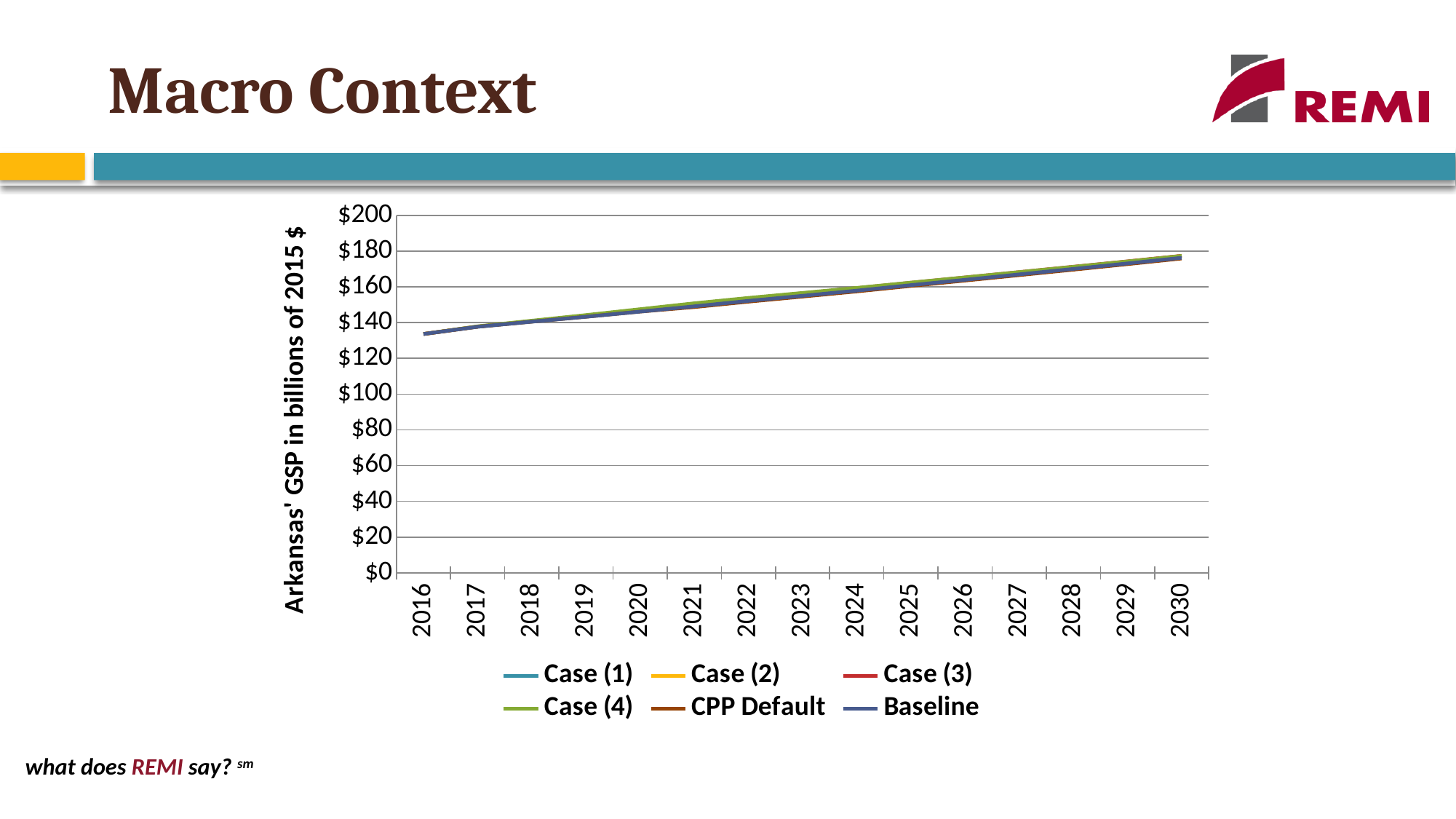
Is the Baseline value for 2023 greater or less than $140? greater Is the Baseline value for 2016 greater or less than $140? less Do the values rise or fall from 2016 to 2030? rise What is the label on the y axis? Arkansas' GSP in billions of 2015 $ Is the Baseline value for 2030 greater or less than $180? less What kind of chart is shown on the slide? line chart How many series does the legend list? 6 Which series is shown in green in the legend? Case (4) In which year is the Baseline value lowest? 2016 How many years are shown along the x axis? 15 In which year is the Baseline value highest? 2030